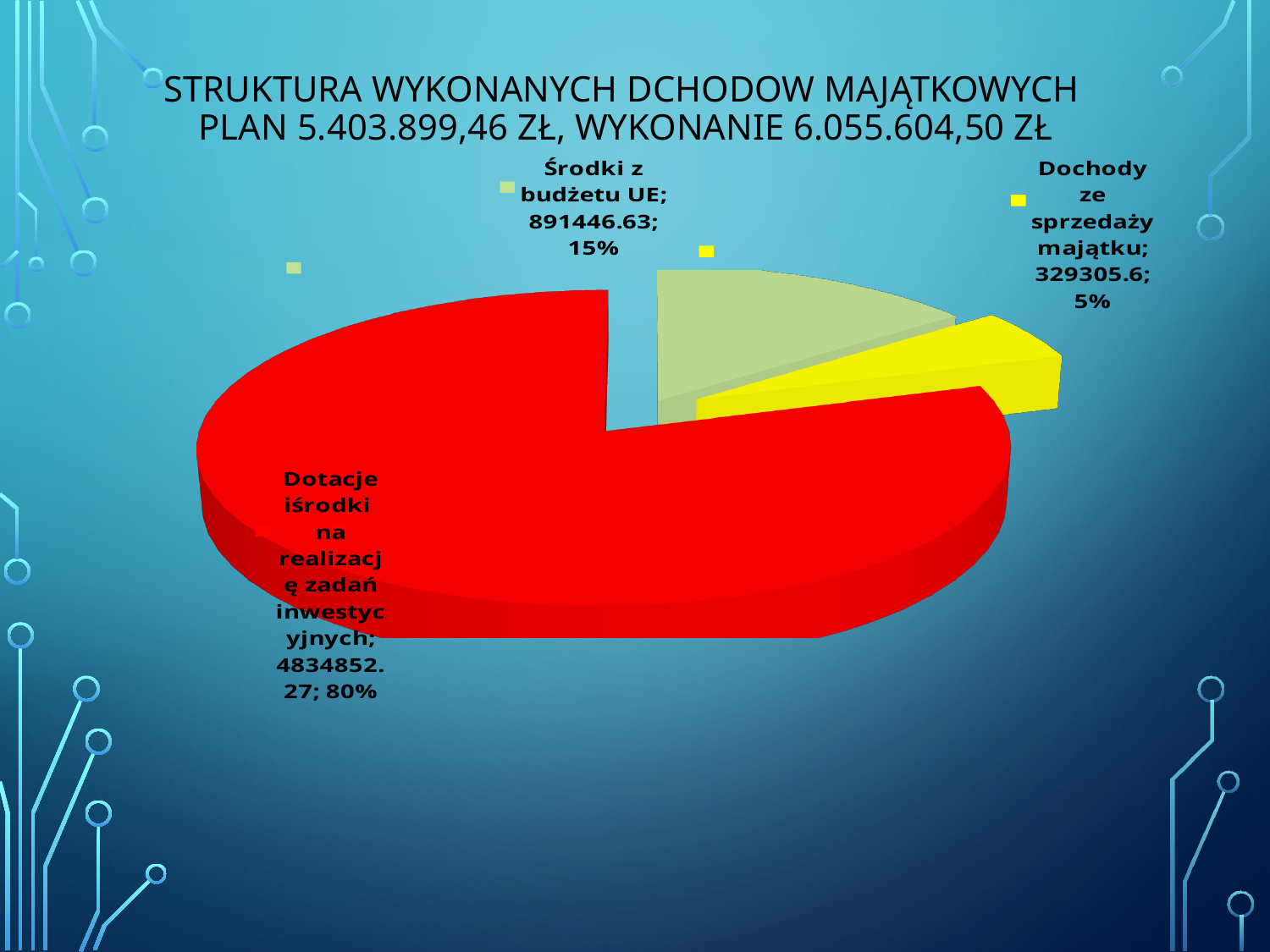
How many slices does the pie chart have? 3 What kind of chart is shown on the slide? pie chart What value is shown for "Środki z budżetu UE"? 891446.63 Which category has the largest slice of the pie? Dotacje i środki na realizację zadań inwestycyjnych Which is larger: "Środki z budżetu UE" or "Dochody ze sprzedaży majątku"? Środki z budżetu UE What share of the pie does "Dotacje i środki na realizację zadań inwestycyjnych" represent? 80% What value is shown for "Dochody ze sprzedaży majątku"? 329305.6 What colour is the slice for "Dotacje i środki na realizację zadań inwestycyjnych"? red What share of the pie does "Dochody ze sprzedaży majątku" represent? 5% What share of the pie does "Środki z budżetu UE" represent? 15% Which category has the smallest slice of the pie? Dochody ze sprzedaży majątku What value is shown for "Dotacje i środki na realizację zadań inwestycyjnych"? 4834852.27